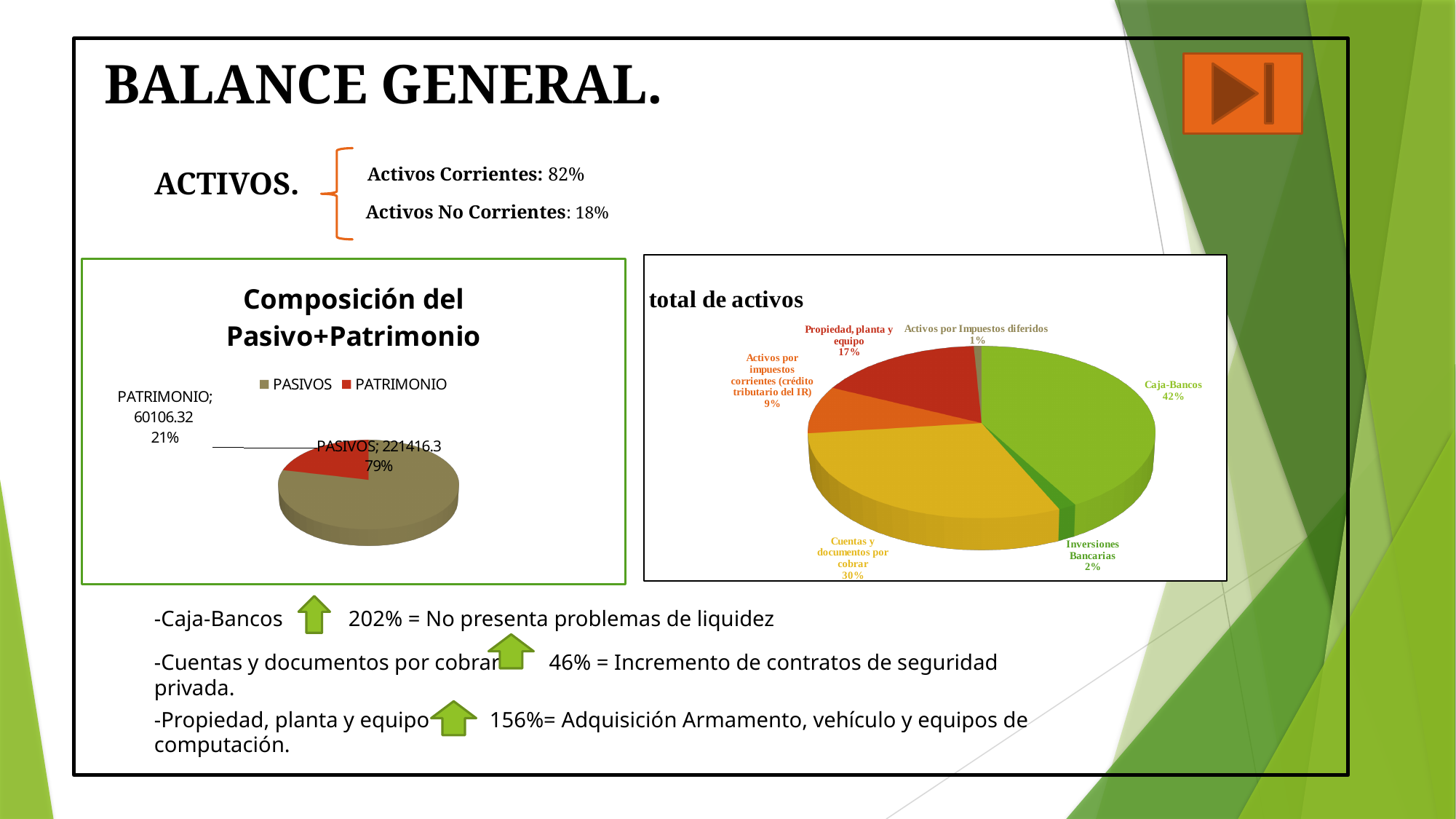
In the 'Composición del Pasivo+Patrimonio' chart, what share of the pie is PATRIMONIO? 21% In the 'total de activos' chart, what share of the pie is Cuentas y documentos por cobrar? 30% What kind of chart is the 'Composición del Pasivo+Patrimonio' chart? Pie chart In the 'Composición del Pasivo+Patrimonio' chart, what is the difference between the PASIVOS and PATRIMONIO values? 161309.98 In the 'total de activos' chart, which category has the smallest share? Activos por Impuestos diferidos In the 'total de activos' chart, which category has the largest share? Caja-Bancos In the 'total de activos' chart, which is larger: Propiedad, planta y equipo or Activos por impuestos corrientes (crédito tributario del IR)? Propiedad, planta y equipo In the 'total de activos' chart, what share of the pie is Caja-Bancos? 42% In the 'Composición del Pasivo+Patrimonio' chart, what is the value for PASIVOS? 221416.3 How many entries does the legend of the 'Composición del Pasivo+Patrimonio' chart list? 2 In the 'total de activos' chart, how many categories are shown? 6 In the 'Composición del Pasivo+Patrimonio' chart, what is the value for PATRIMONIO? 60106.32